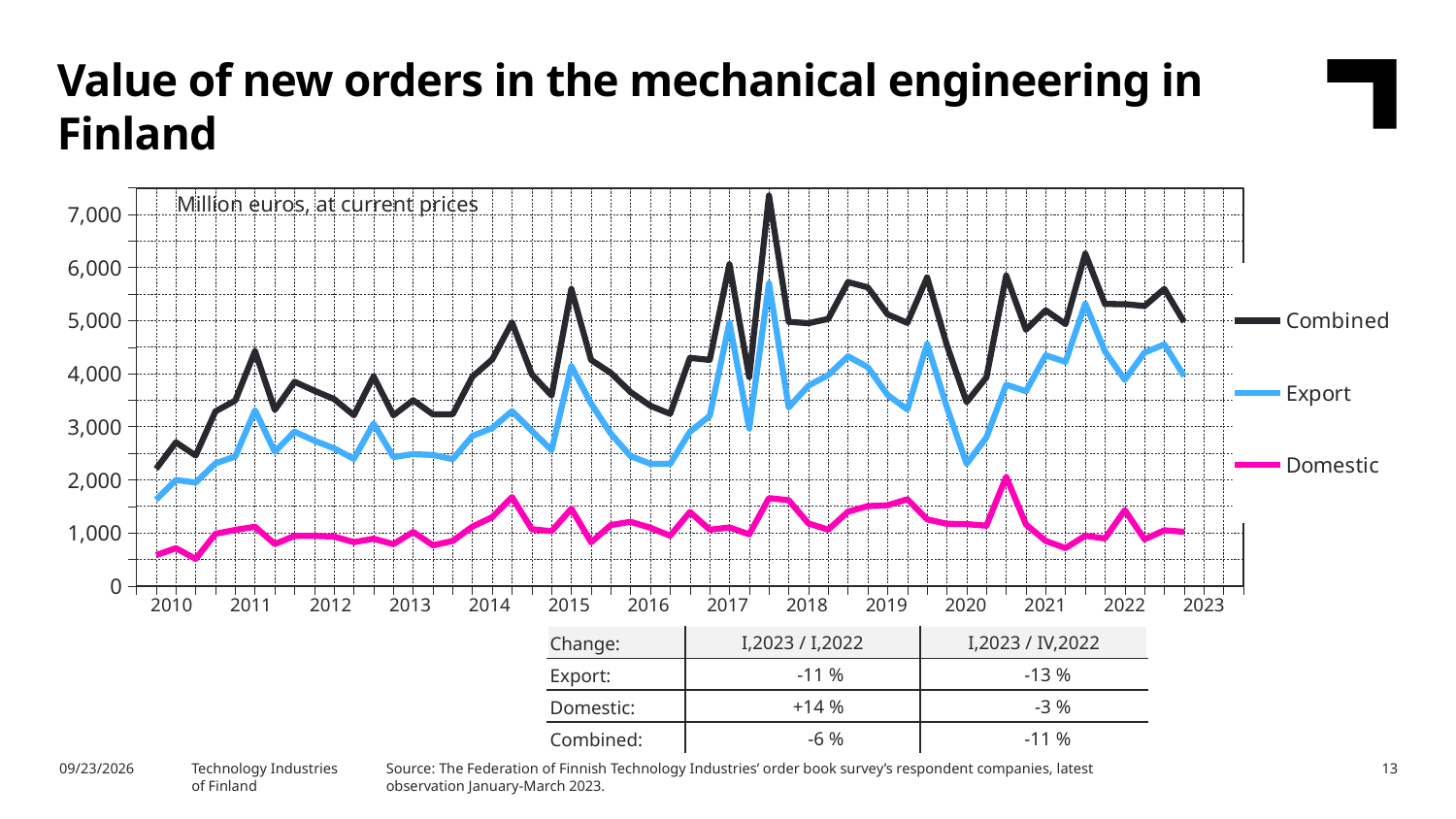
What unit is stated for the values in the chart? Million euros, at current prices Which series has the highest values throughout the chart? Combined Which series is plotted with the black line? Combined What kind of chart is shown on the slide? line chart Is the Domestic series ever greater or less than 3,000 across the whole period? less How many series does the legend list? 3 Which is larger at the 2020 low point: the Export value or the Domestic value? Export Is the Export value at the start of 2010 greater or less than 2,000? less Does the Combined series rise or fall from 2010 to 2011? rise Is the Combined value at the end of 2023 greater or less than 4,000? greater Which series has the lowest values throughout the chart? Domestic